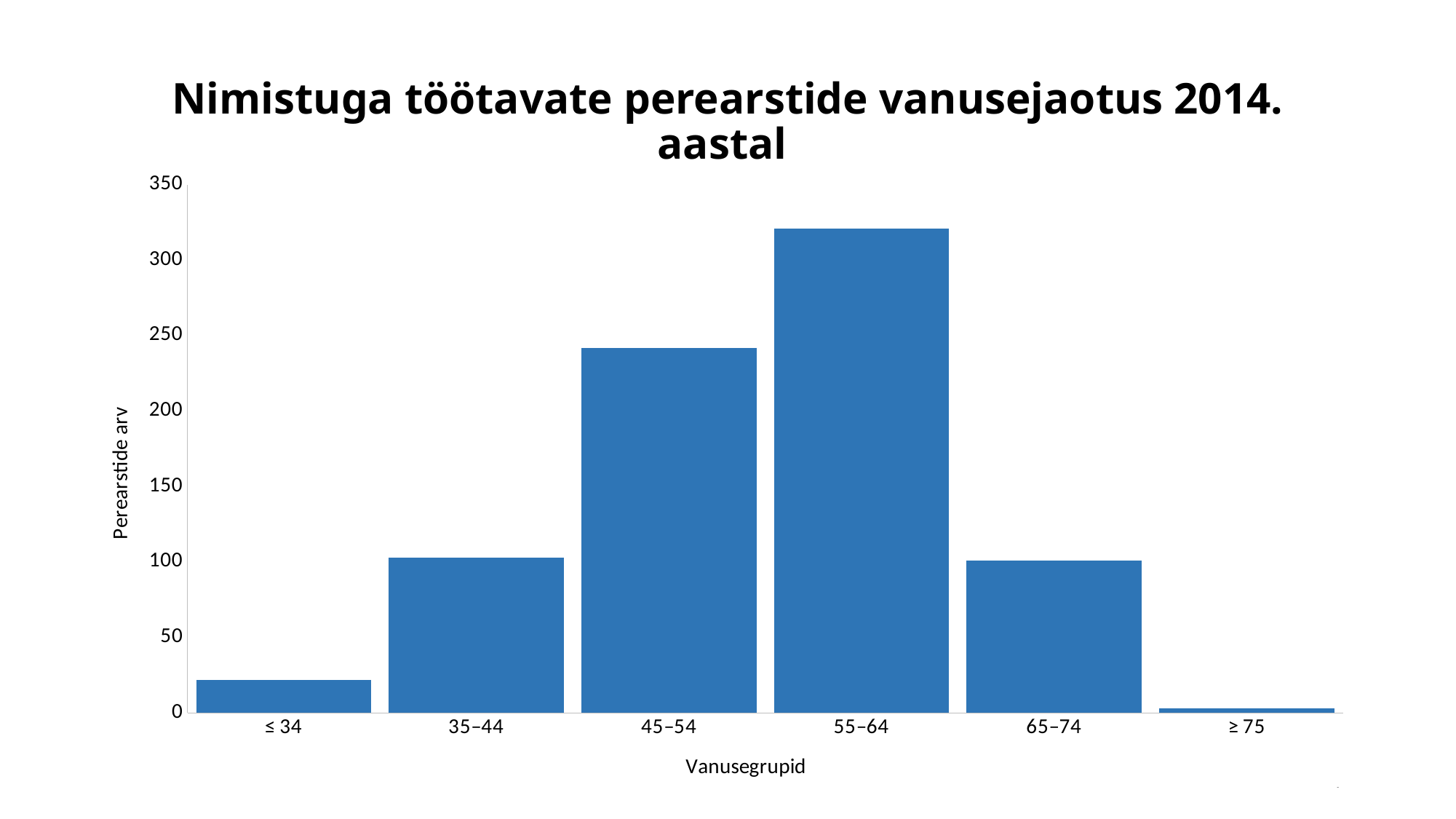
What is the label of the y axis? Perearstide arv Which age group has the highest number of family doctors? 55–64 Is the value for the 35–44 age group greater or less than 150? less Is the value for the 45–54 age group greater or less than 200? greater Which age group has the lowest number of family doctors? ≥ 75 Which has a larger value, the 45–54 age group or the 55–64 age group? 55–64 Is the value for the ≤ 34 age group greater or less than 50? less How many age groups are shown on the x axis? 6 What kind of chart is shown on the slide? bar chart What is the title of the chart? Nimistuga töötavate perearstide vanusejaotus 2014. aastal